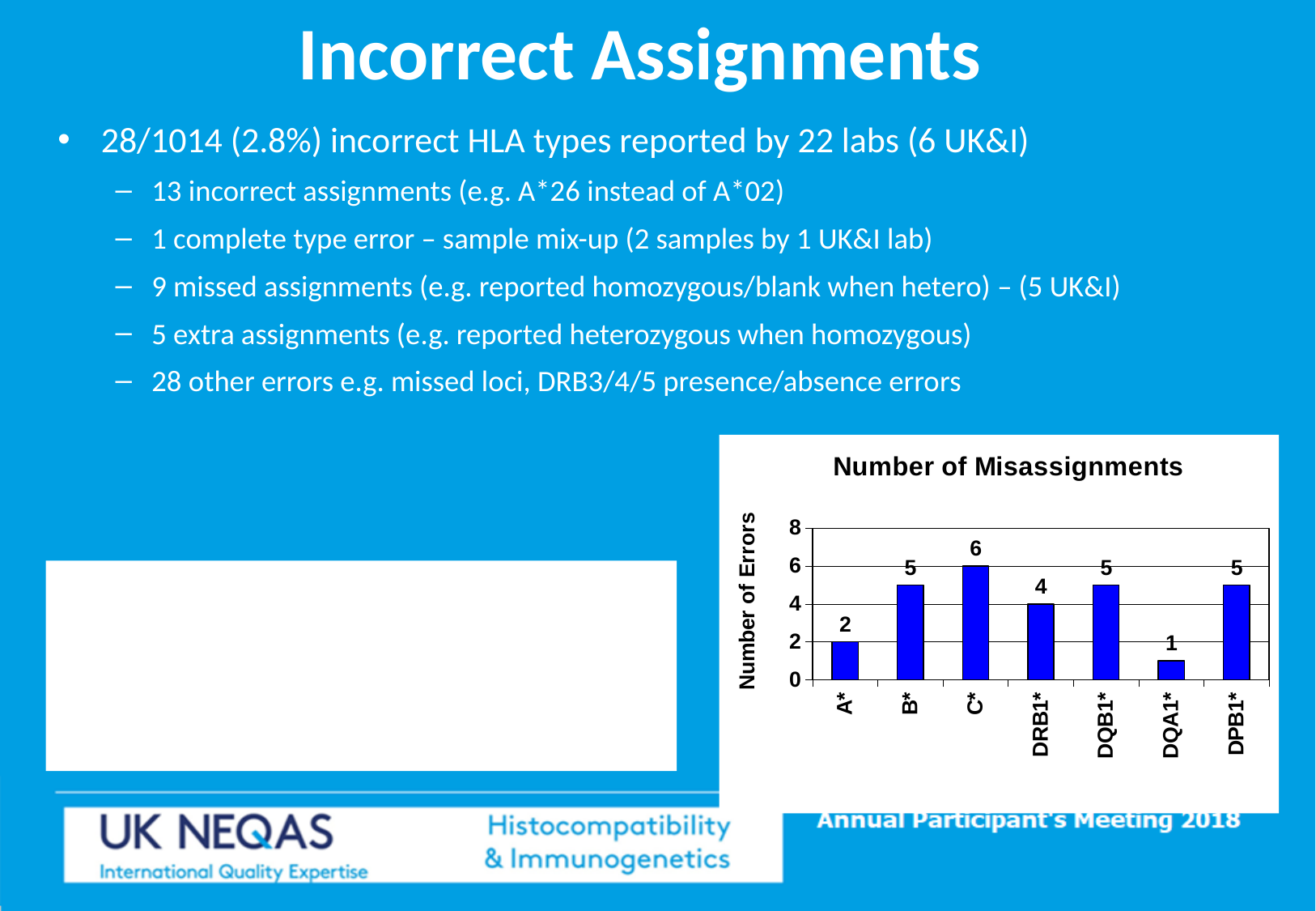
Which has more errors, DRB1* or DQB1*? DQB1* What is the number of errors for DQA1*? 1 Which locus has the highest number of errors? C* What is the number of errors for DRB1*? 4 What is the label of the y axis of the chart? Number of Errors Which locus has the lowest number of errors? DQA1* What is the number of errors for A*? 2 What is the number of errors for C* in the Number of Misassignments chart? 6 How many loci are shown on the x axis of the chart? 7 What kind of chart is the Number of Misassignments chart? bar chart What is the difference in number of errors between C* and A*? 4 What is the title of the chart? Number of Misassignments